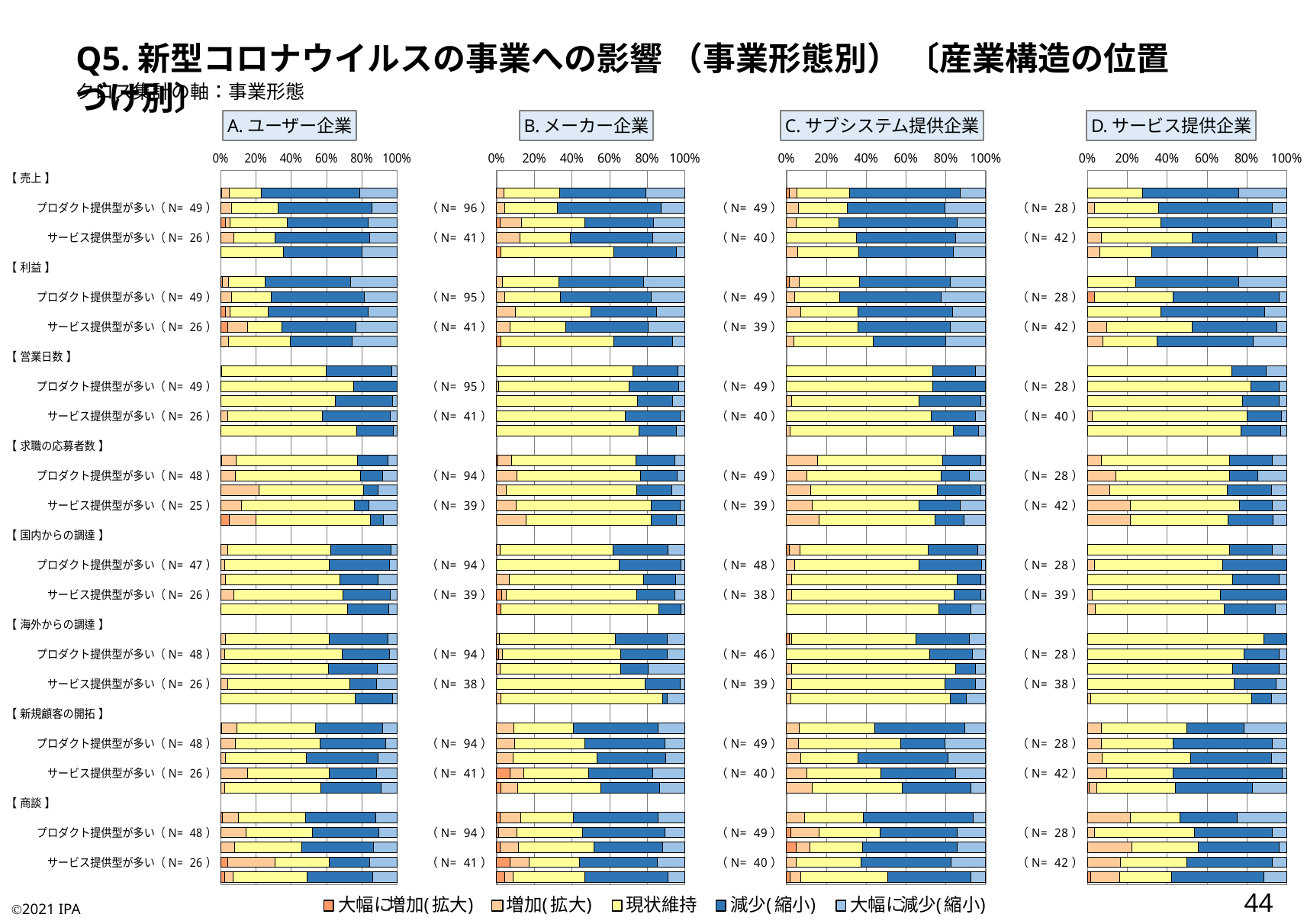
In chart B. メーカー企業, what is the N value shown for サービス提供型が多い under 売上? 41 In chart C. サブシステム提供企業, is the 現状維持 share for 求職の応募者数 プロダクト提供型が多い (N=49) greater or less than 40%? greater In chart D. サービス提供企業, is the 現状維持 share for 営業日数 プロダクト提供型が多い (N=28) greater or less than 60%? greater In chart A. ユーザー企業, is the 現状維持 share for 売上 プロダクト提供型が多い (N=49) greater or less than 60%? less Which legend entry is shown in yellow? 現状維持 How many separate charts are shown on the slide? 4 How many series does the legend at the bottom of the slide list? 5 What kind of chart is used in the four panels on this slide? bar chart How many item groups (such as 【売上】, 【利益】) are listed down the left side of the charts? 8 What is the title of the third chart from the left? C. サブシステム提供企業